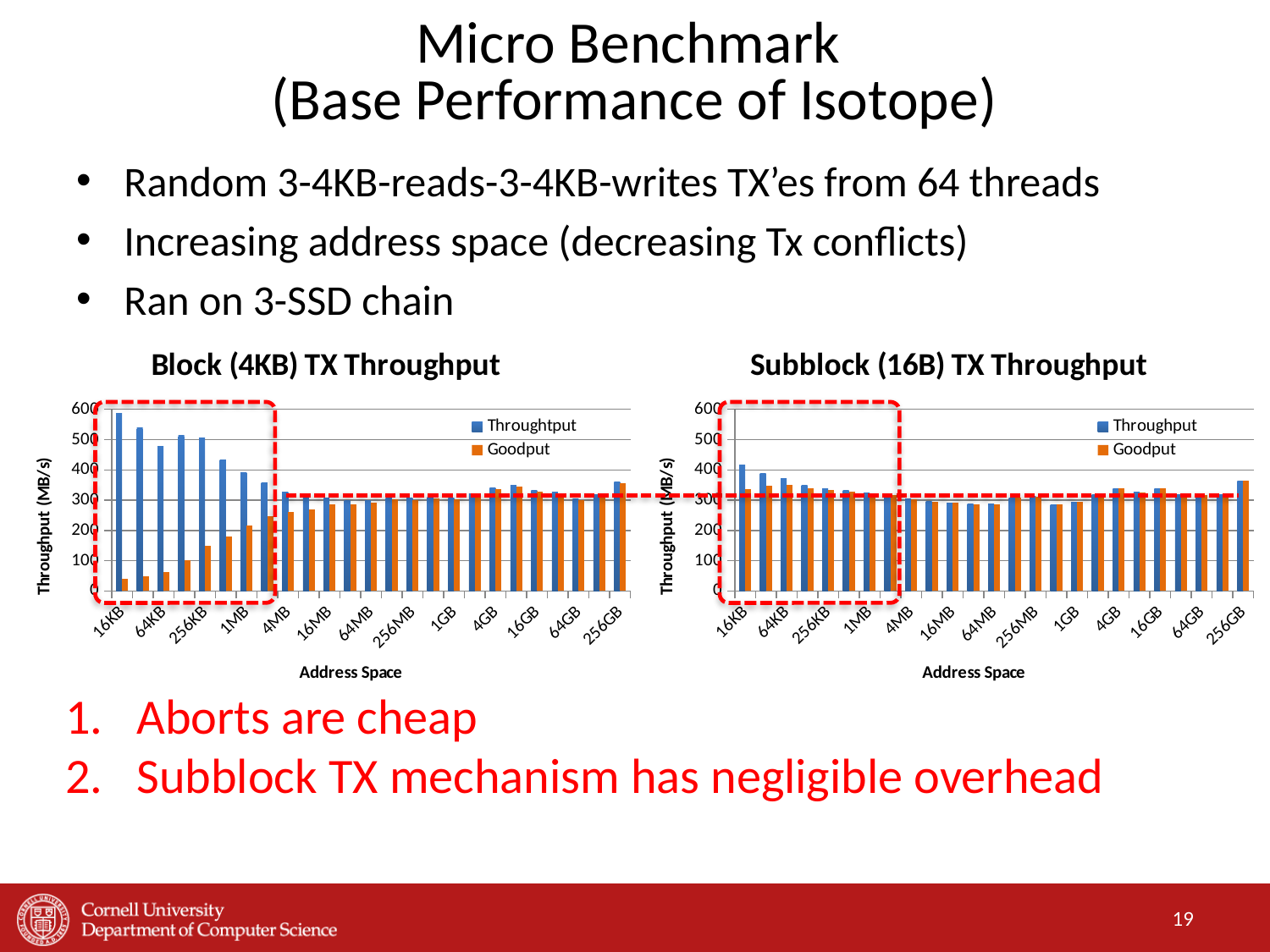
In the Block (4KB) TX Throughput chart, is the Throughput value at 16KB greater or less than 500? greater In the Block (4KB) TX Throughput chart, does the Throughput series rise or fall from 16KB to 4MB? fall In the Subblock (16B) TX Throughput chart, at 16KB, which is larger: Throughput or Goodput? Throughput What kind of chart is the Block (4KB) TX Throughput chart? bar chart In the Block (4KB) TX Throughput chart, is the Goodput value at 16KB greater or less than 100? less In the Block (4KB) TX Throughput chart, what are the two legend entries? Throughtput and Goodput In the Subblock (16B) TX Throughput chart, at which address space is the Throughput bar highest? 16KB How many series does the legend of the Subblock (16B) TX Throughput chart list? 2 In the Subblock (16B) TX Throughput chart, is the Throughput value at 16KB greater or less than 300? greater In the Block (4KB) TX Throughput chart, does the Goodput series rise or fall from 16KB to 4MB? rise In the Block (4KB) TX Throughput chart, at which address space is the Throughput bar highest? 16KB What is the y-axis title of the Subblock (16B) TX Throughput chart? Throughput (MB/s)